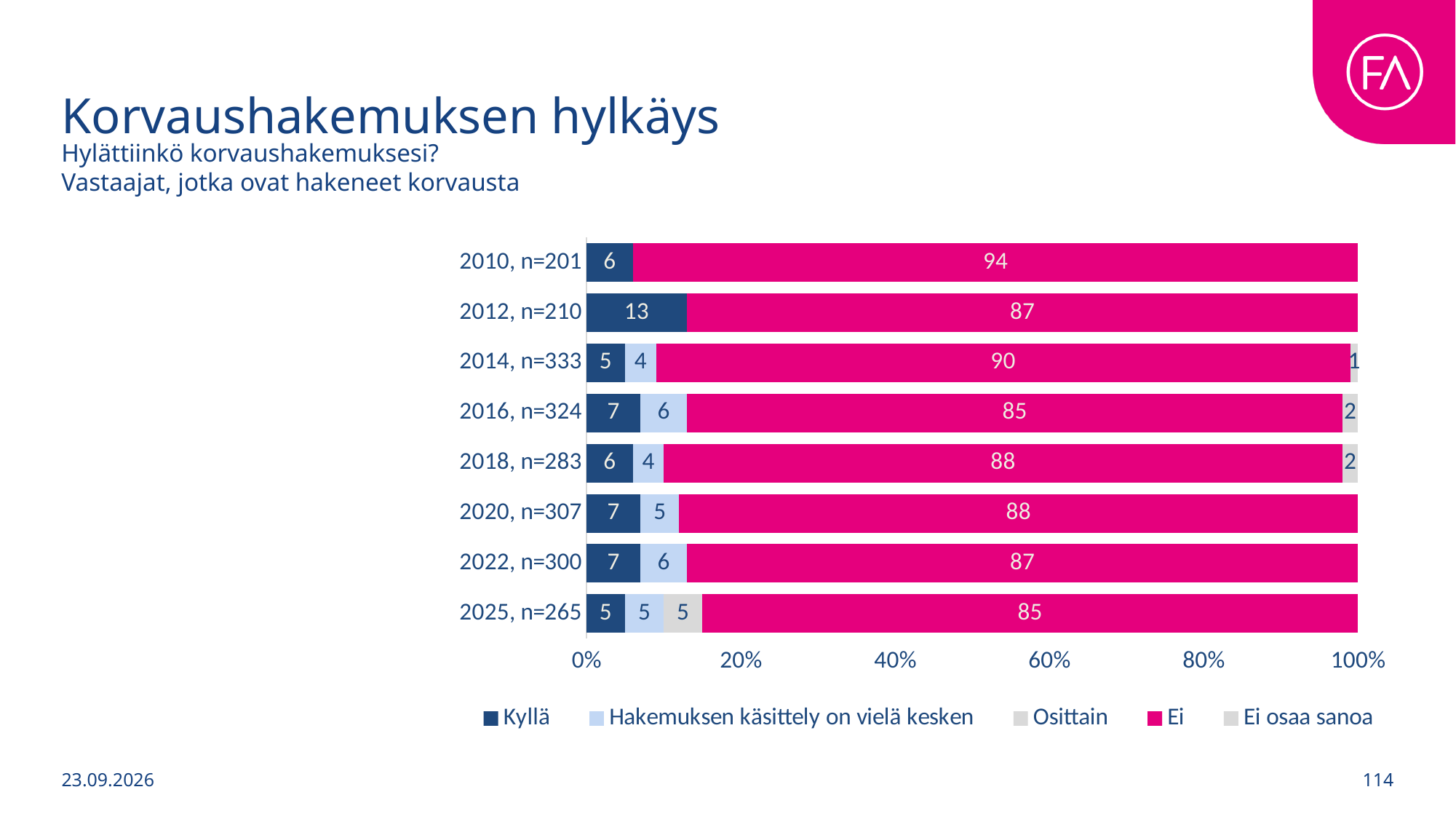
What is the value of "Ei osaa sanoa" for 2018, n=283? 2 Which year has the highest value for "Ei"? 2010, n=201 What kind of chart is shown on the slide? Stacked bar chart What is the value of "Hakemuksen käsittely on vielä kesken" for 2016, n=324? 6 Is the value for "Ei" in 2012, n=210 greater or less than 80%? greater How many series does the legend list? 5 How many year categories are shown in the chart? 8 What is the difference between the "Ei" value for 2010, n=201 and for 2025, n=265? 9 What is the value of "Ei" for 2010, n=201? 94 What is the value of "Kyllä" for 2012, n=210? 13 Which year has the highest value for "Kyllä"? 2012, n=210 Which is larger: the "Ei" value for 2014, n=333 or for 2018, n=283? 2014, n=333